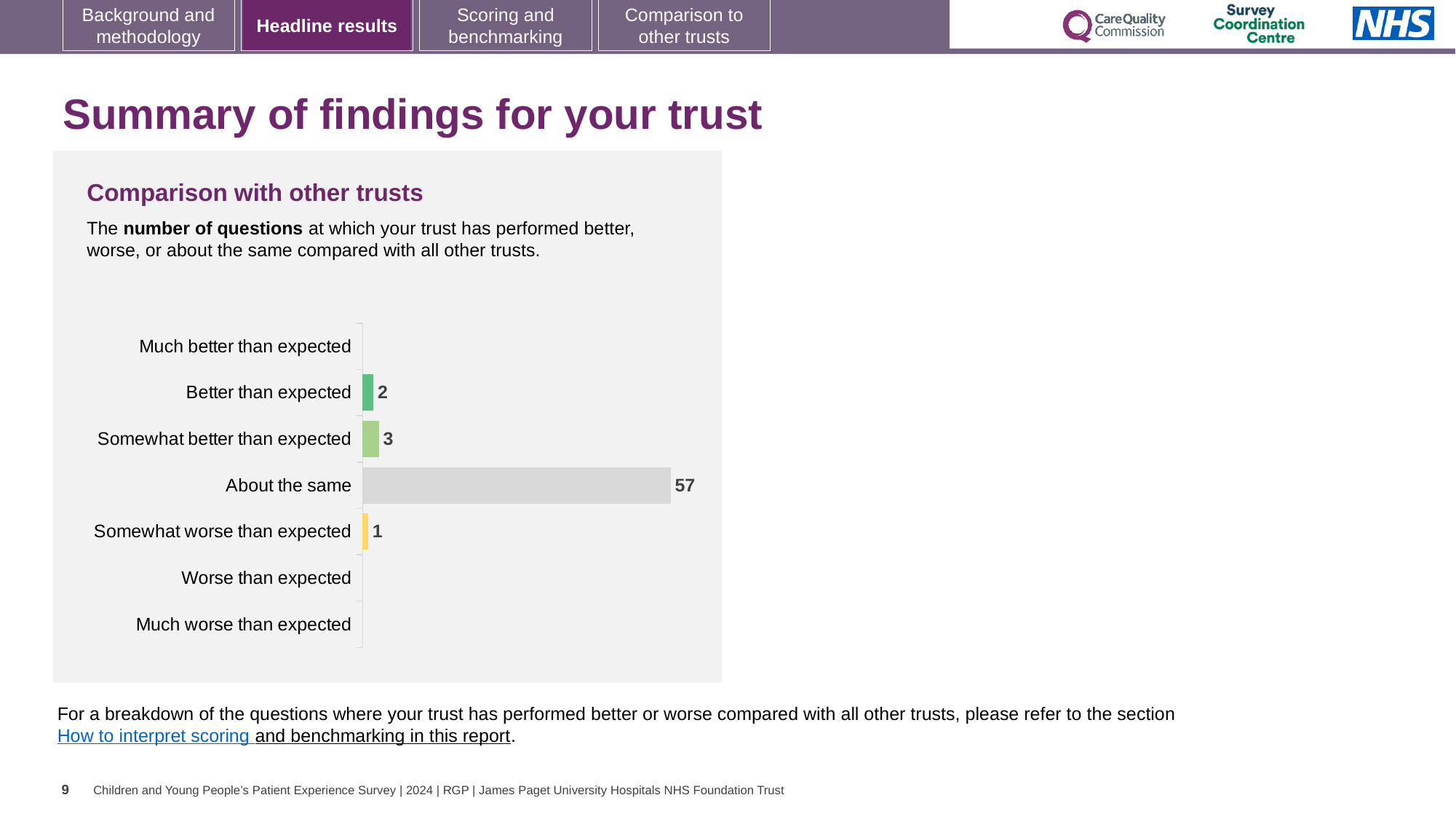
How many categories are listed on the chart's axis? 7 What is the value for 'Somewhat worse than expected'? 1 What is the value for 'Somewhat better than expected'? 3 What colour is the bar for 'Somewhat worse than expected'? Yellow How many questions are in the 'About the same' category? 57 What is the value for 'Better than expected'? 2 What kind of chart is shown on the slide? Bar chart Which category has the highest number of questions? About the same What is the difference between the number of questions 'About the same' and 'Somewhat better than expected'? 54 Which is larger: the value for 'Somewhat better than expected' or 'Better than expected'? Somewhat better than expected What is the total number of questions across the categories with labelled bars? 63 What is the title of the chart section? Comparison with other trusts